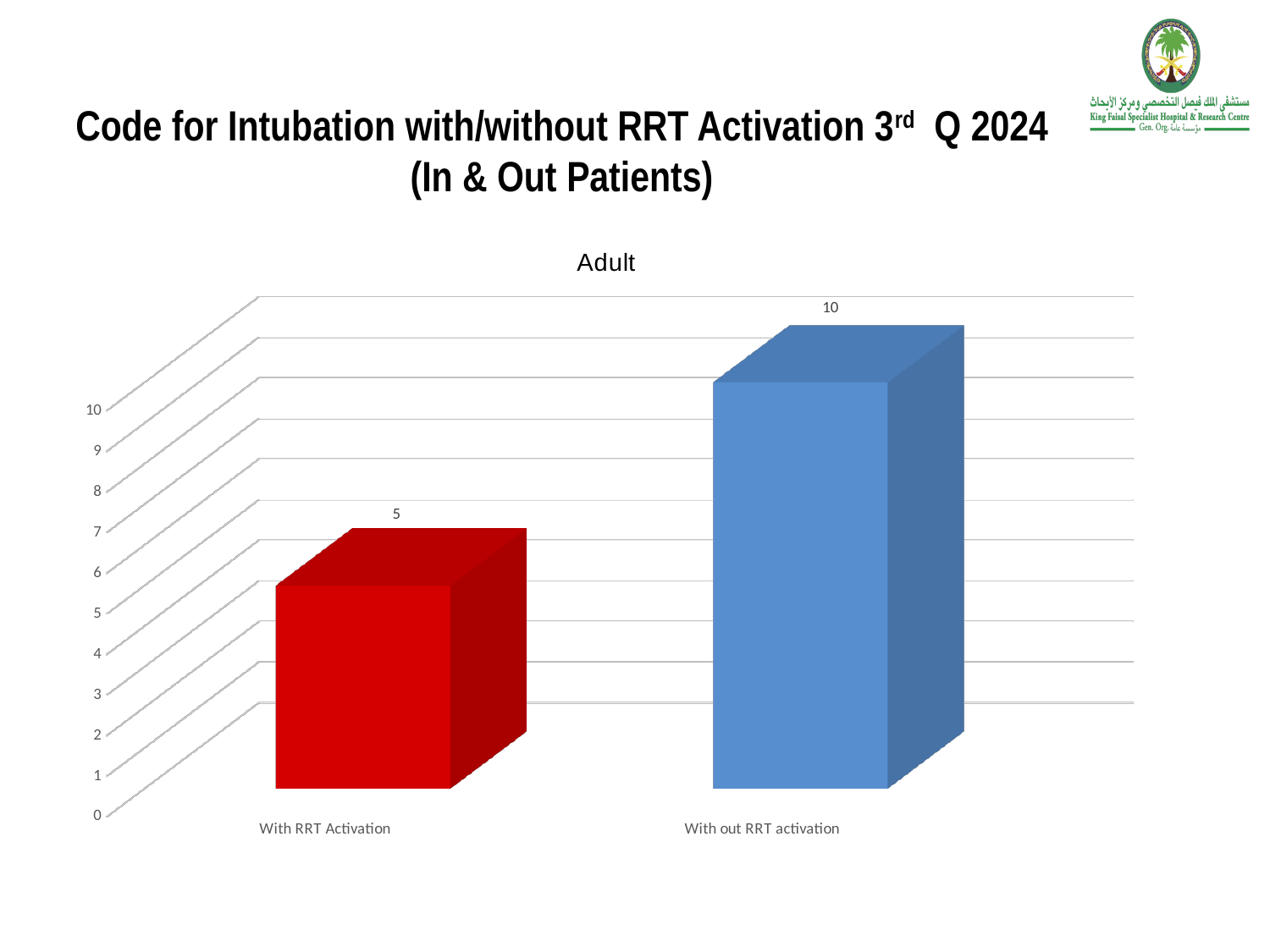
What is the value for With RRT Activation? 5 What kind of chart is shown on the slide? bar chart Which category has the highest value? With out RRT activation Which category has the lowest value? With RRT Activation What is the difference between the values for With out RRT activation and With RRT Activation? 5 What is the title of the chart? Adult What is the value for With out RRT activation? 10 What colour is the bar for With RRT Activation? red Which is larger, the value for With RRT Activation or the value for With out RRT activation? With out RRT activation How many categories are shown in the chart? 2 Is the value for With RRT Activation greater or less than 8? less What is the total of the two values shown in the chart? 15